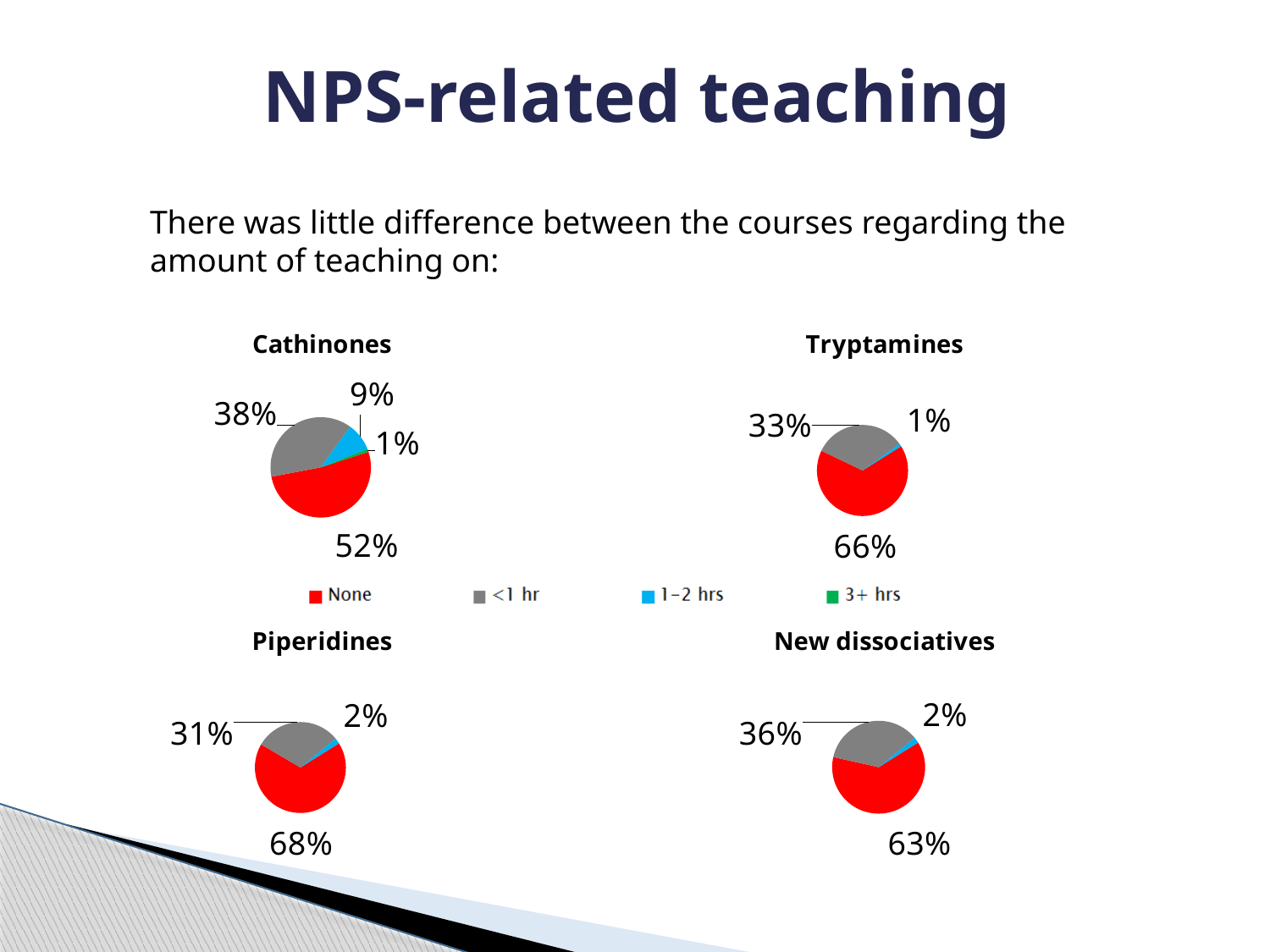
How many entries does the shared legend list? 4 Which is larger: the None share in the Piperidines pie chart or the None share in the Cathinones pie chart? Piperidines In the Piperidines pie chart, which category has the smallest share? 1-2 hrs In the Tryptamines pie chart, what percentage is shown for <1 hr? 33% In the Piperidines pie chart, what percentage is shown for None? 68% What type of chart is used for Cathinones, Tryptamines, Piperidines and New dissociatives? Pie chart In the New dissociatives pie chart, what is the difference between the None share and the <1 hr share? 27% In the New dissociatives pie chart, what percentage is shown for <1 hr? 36% Which colour represents None in the legend? Red In the Tryptamines pie chart, which category has the largest share? None In the Cathinones pie chart, what percentage is shown for 1-2 hrs? 9% In the Cathinones pie chart, what percentage is shown for None? 52%